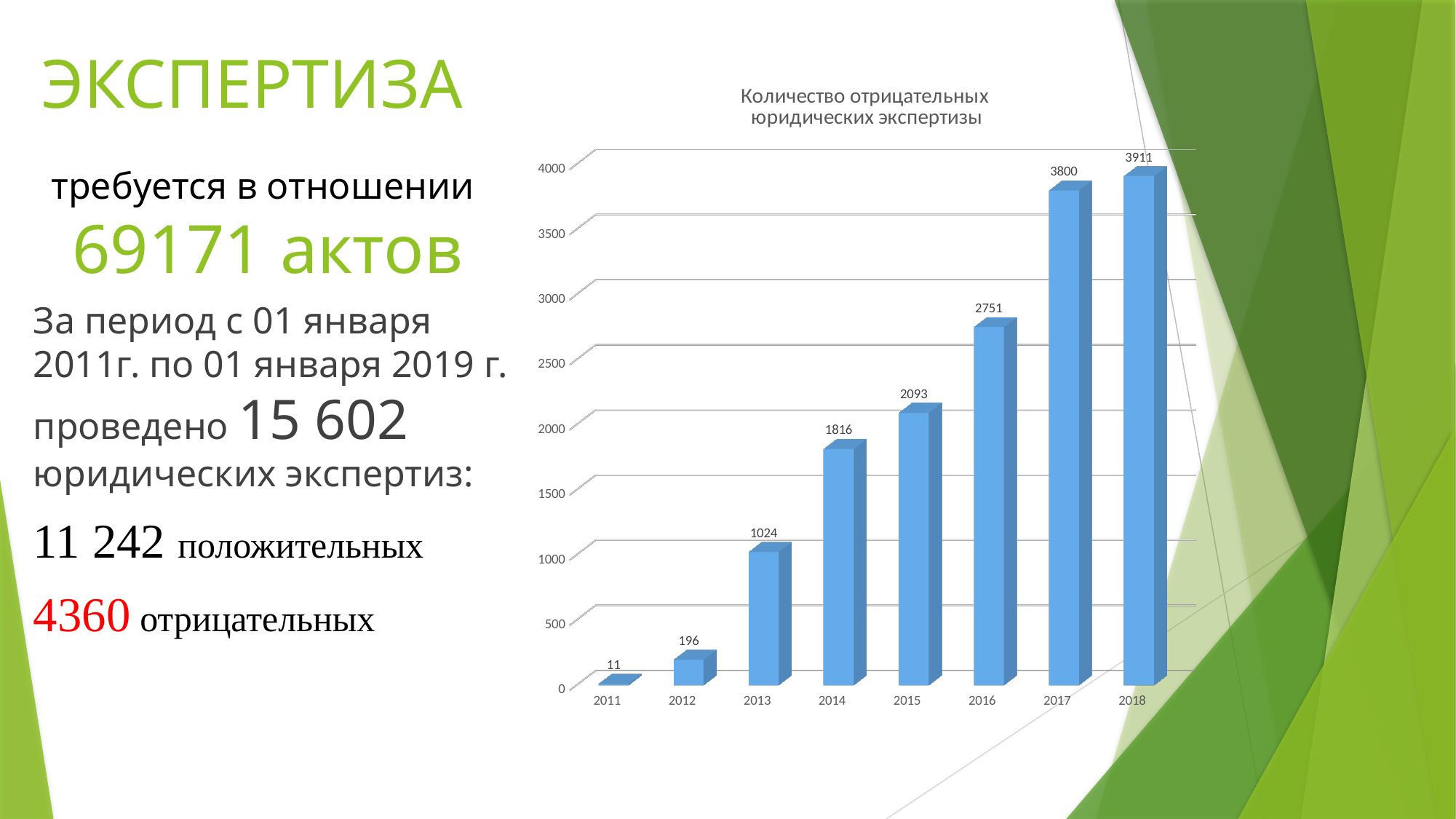
Do the values rise or fall from 2011 to 2018? rise Which is larger, the value for 2014 or the value for 2012? 2014 Which year has the lowest value? 2011 How many years are shown on the x axis? 8 What is the difference between the values for 2015 and 2014? 277 What is the value for 2011? 11 What is the value for 2016? 2751 What kind of chart is shown on the slide? bar chart Is the value for 2016 greater or less than 2500? greater Which year has the highest value? 2018 What is the difference between the values for 2018 and 2017? 111 What is the value for 2013? 1024